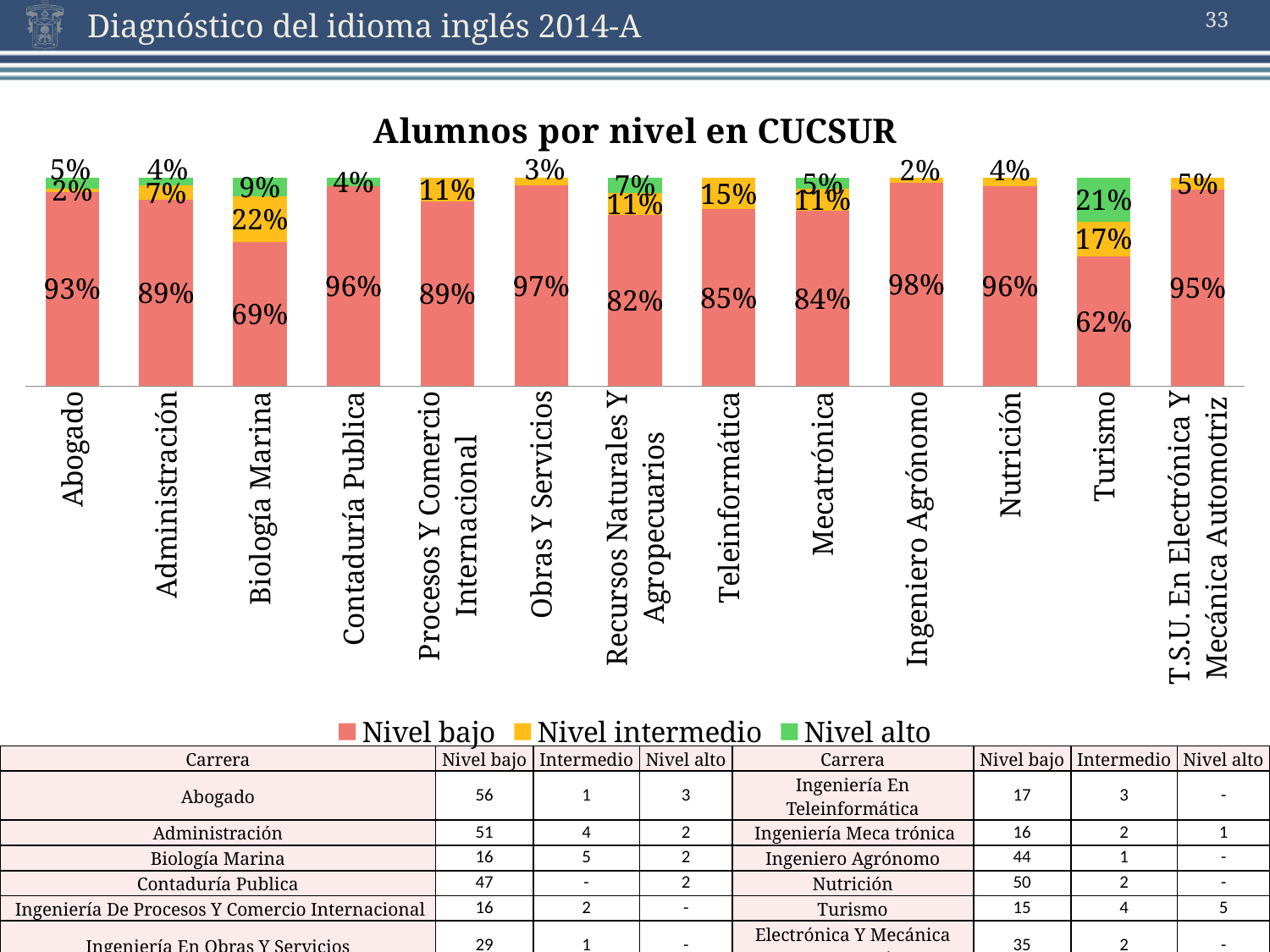
Which career has the highest Nivel bajo percentage? Ingeniero Agrónomo What is the Nivel intermedio percentage for Biología Marina? 22% What is the title of the chart? Alumnos por nivel en CUCSUR How many careers (categories) are plotted on the x axis of the chart? 13 What is the Nivel bajo percentage for Turismo? 62% What is the Nivel intermedio percentage for Teleinformática? 15% What kind of chart is shown on the slide? stacked bar chart What is the difference between the Nivel bajo percentages of Obras Y Servicios and Turismo? 35% What is the Nivel bajo percentage for Ingeniero Agrónomo? 98% Which has a larger Nivel bajo percentage, Biología Marina or Contaduría Publica? Contaduría Publica How many series does the chart legend list? 3 Which career has the lowest Nivel bajo percentage? Turismo